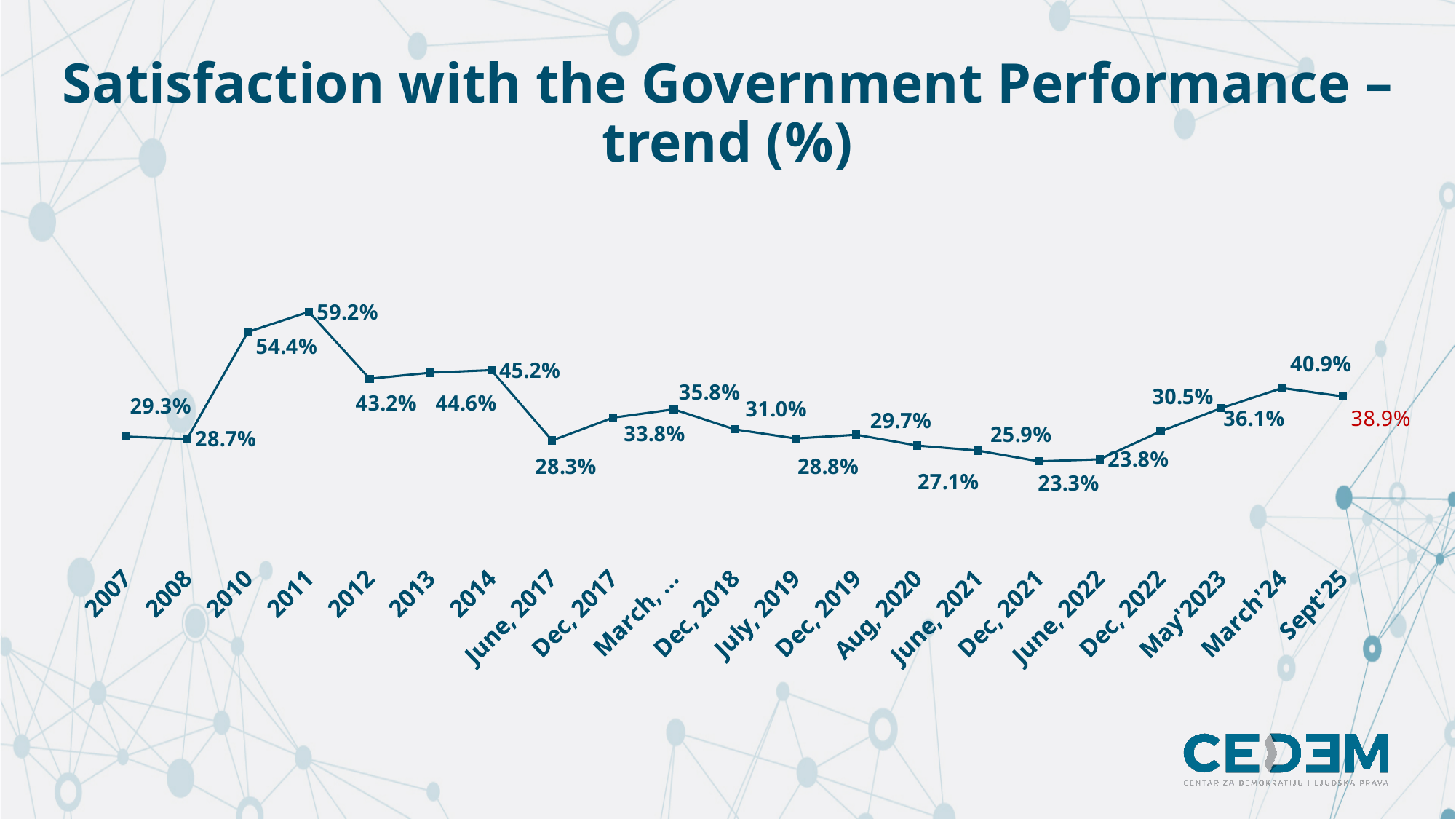
Does the satisfaction value rise or fall from Dec, 2021 to March'24? Rise Which is larger, the value for 2014 or the value for 2012? 2014 Which time point has the lowest satisfaction value? Dec, 2021 What is the difference between the values for 2011 and 2010? 4.8 percentage points Which time point has the highest satisfaction value? 2011 What is the satisfaction value for Dec, 2021? 23.3% How many time points are plotted on the chart? 21 What is the difference between the values for March'24 and Sept'25? 2.0 percentage points What is the satisfaction value for May'2023? 36.1% What is the satisfaction value for Sept'25? 38.9% What type of chart is shown on the slide? Line chart What is the satisfaction value for 2011? 59.2%